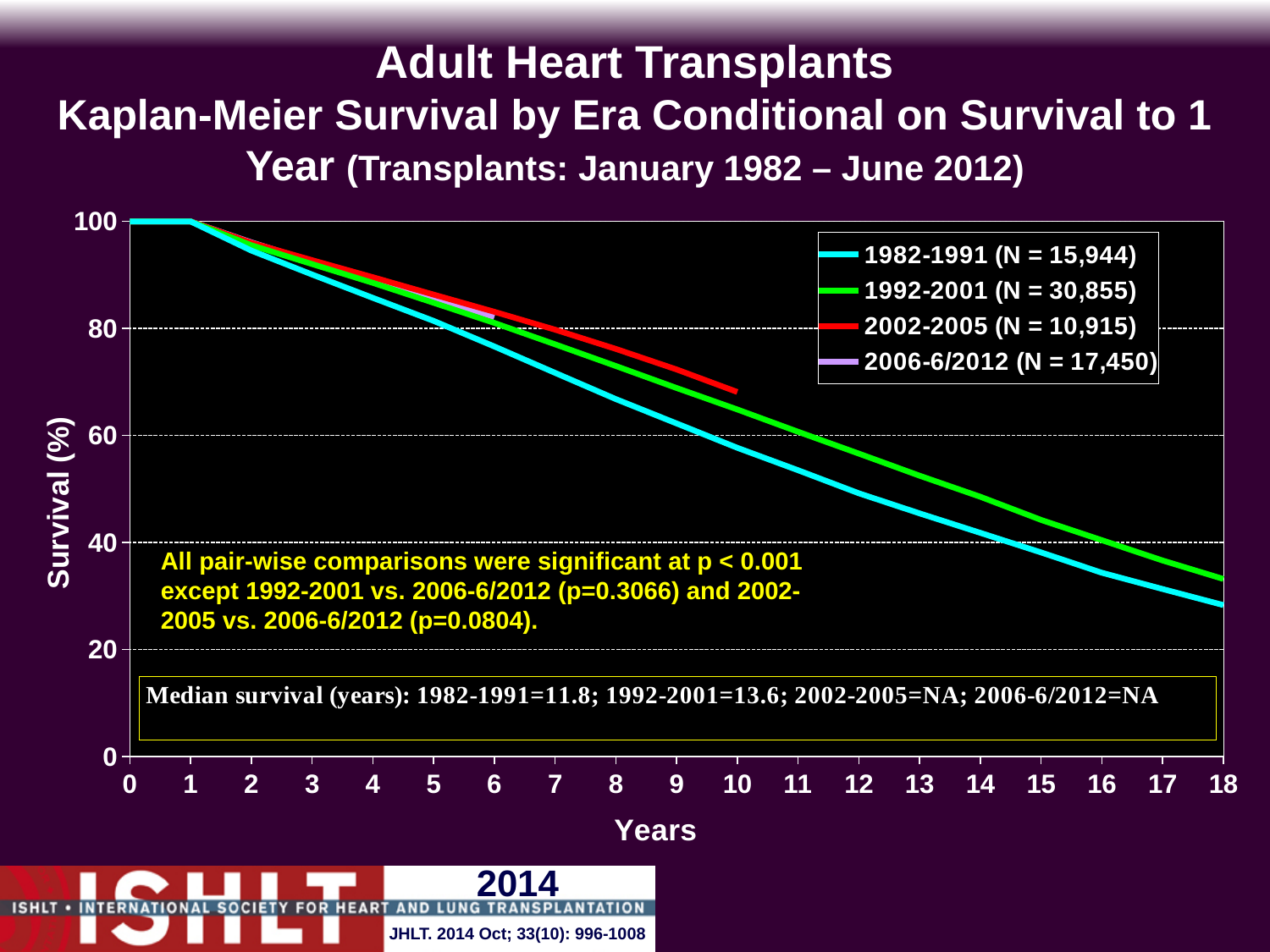
What is the N for the 1982-1991 era shown in the legend? 15,944 How many series does the legend list? 4 What kind of chart is shown on the slide? Line chart Do the survival curves rise or fall as years increase? Fall What is the N for the 1992-2001 era shown in the legend? 30,855 What is the label on the x axis? Years What is the median survival in years for the 1992-2001 era? 13.6 What is the median survival in years for the 1982-1991 era? 11.8 Is the survival value for the 2002-2005 era at 10 years greater or less than 60? greater Is the survival value for the 1982-1991 era at 18 years greater or less than 40? less At 15 years, which era has higher survival: 1982-1991 or 1992-2001? 1992-2001 What is the N for the 2006-6/2012 era shown in the legend? 17,450